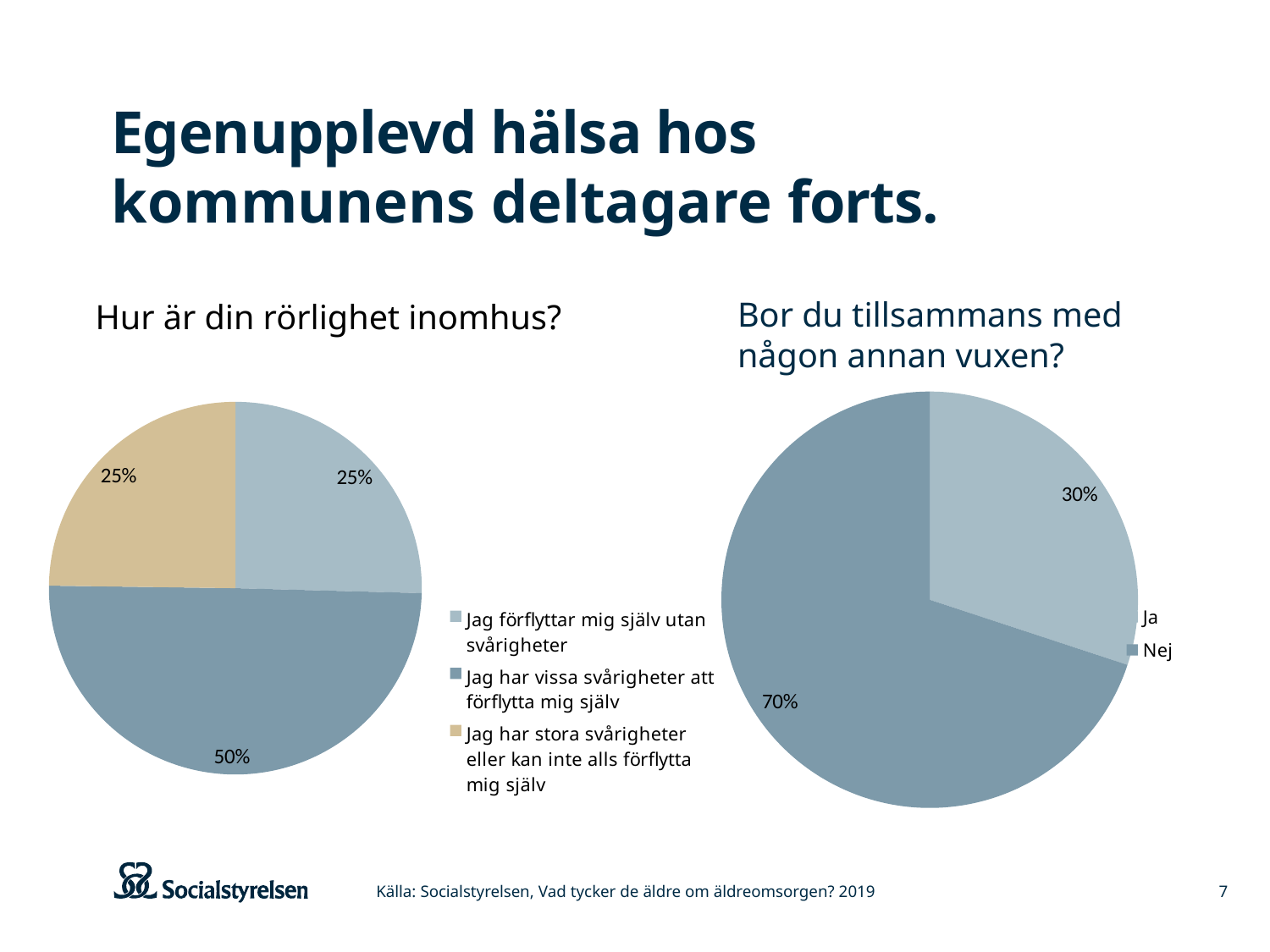
In the chart 'Bor du tillsammans med någon annan vuxen?', what share answered 'Ja'? 30% In the chart 'Hur är din rörlighet inomhus?', which category has the largest slice? Jag har vissa svårigheter att förflytta mig själv In the chart 'Bor du tillsammans med någon annan vuxen?', what share answered 'Nej'? 70% In the chart 'Hur är din rörlighet inomhus?', what share is 'Jag har stora svårigheter eller kan inte alls förflytta mig själv'? 25% In the chart 'Hur är din rörlighet inomhus?', what is the difference in percentage points between 'Jag har vissa svårigheter att förflytta mig själv' and 'Jag förflyttar mig själv utan svårigheter'? 25 percentage points In the chart 'Hur är din rörlighet inomhus?', what share is 'Jag förflyttar mig själv utan svårigheter'? 25% In the chart 'Bor du tillsammans med någon annan vuxen?', which answer has the larger slice, 'Ja' or 'Nej'? Nej What type of chart is used for 'Bor du tillsammans med någon annan vuxen?'? Pie chart What is the title of the chart on the left side of the slide? Hur är din rörlighet inomhus? In the chart 'Bor du tillsammans med någon annan vuxen?', what is the difference in percentage points between 'Nej' and 'Ja'? 40 percentage points In the chart 'Hur är din rörlighet inomhus?', what share is 'Jag har vissa svårigheter att förflytta mig själv'? 50% In the chart 'Hur är din rörlighet inomhus?', how many categories does the legend list? 3